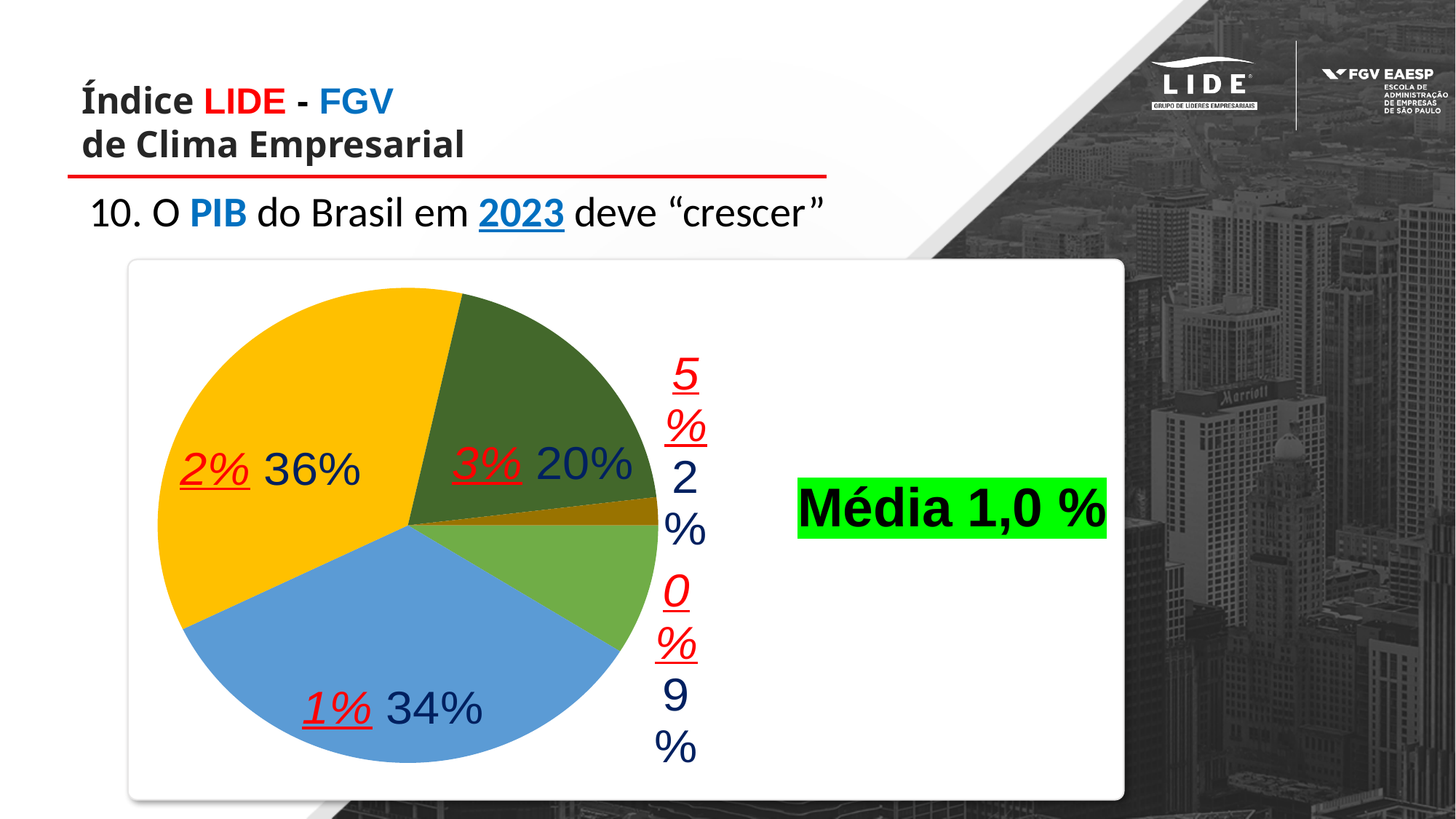
Which growth expectation has the smallest slice of the pie? 5% Which has a larger share of respondents: 3% growth or 0% growth? 3% growth How many percentage points larger is the share for 2% growth than the share for 1% growth? 2 percentage points What is the difference in percentage points between the share for 3% growth and the share for 0% growth? 11 percentage points How many slices does the pie chart have? 5 What share of respondents expect growth of 3%? 20% Which growth expectation has the largest slice of the pie? 2% What type of chart is shown on the slide? Pie chart What share of respondents expect growth of 5%? 2% What share of respondents expect growth of 1%? 34% What share of respondents expect growth of 0%? 9% What share of respondents expect Brazil's 2023 GDP to grow 2%? 36%